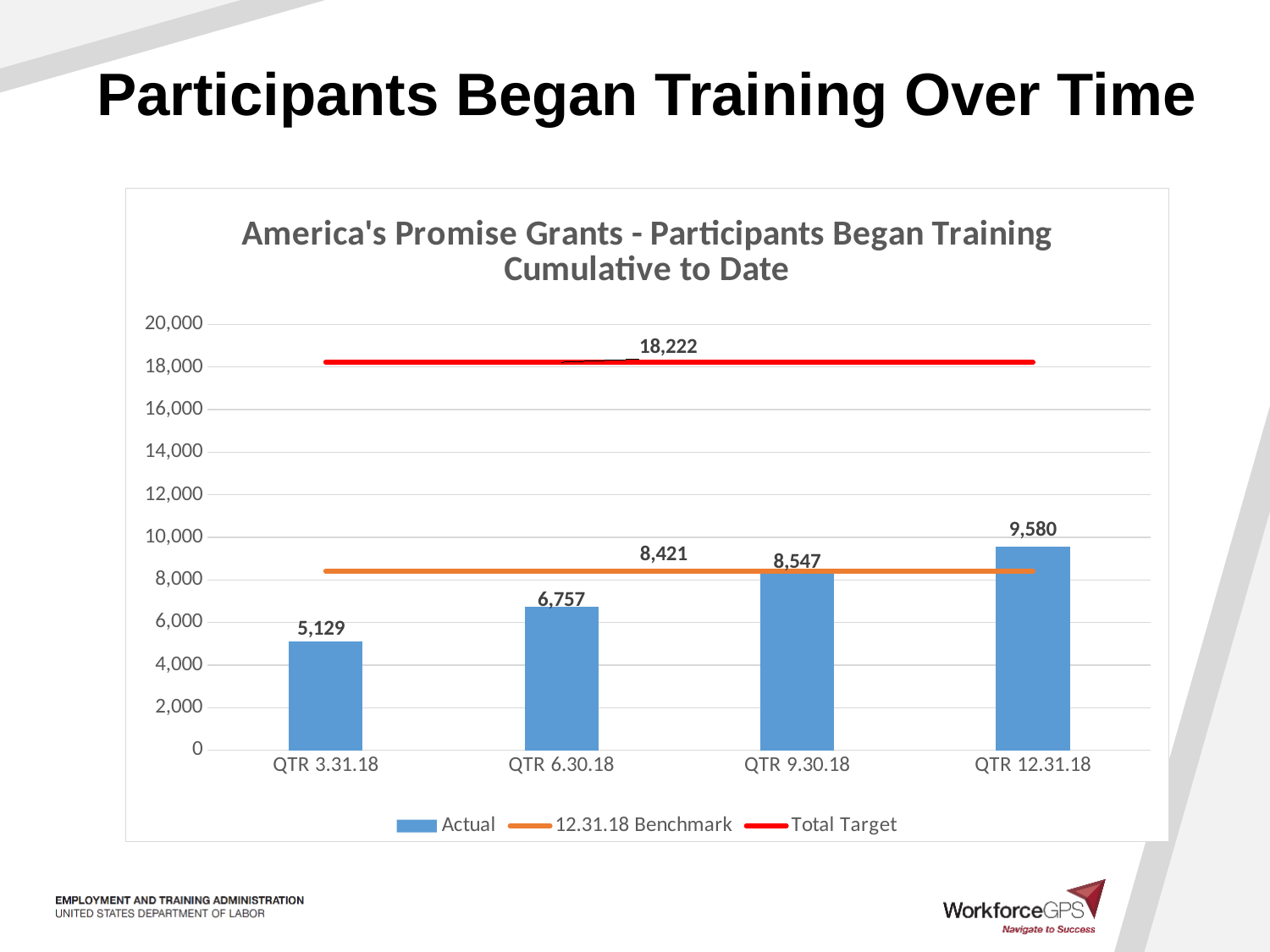
How many quarters are shown on the x axis? 4 How many series does the legend list? 3 What value is labelled on the 12.31.18 Benchmark line? 8,421 What value is labelled on the Total Target line? 18,222 What is the difference between the Actual values for QTR 12.31.18 and QTR 3.31.18? 4,451 What is the Actual value for QTR 3.31.18? 5,129 Which quarter has the highest Actual value? QTR 12.31.18 Do the Actual values rise or fall from QTR 3.31.18 to QTR 12.31.18? rise Which quarter has the lowest Actual value? QTR 3.31.18 Which is larger, the Actual value for QTR 9.30.18 or the 12.31.18 Benchmark? QTR 9.30.18 Actual What is the Actual value for QTR 12.31.18? 9,580 What is the title of the chart? America's Promise Grants - Participants Began Training Cumulative to Date